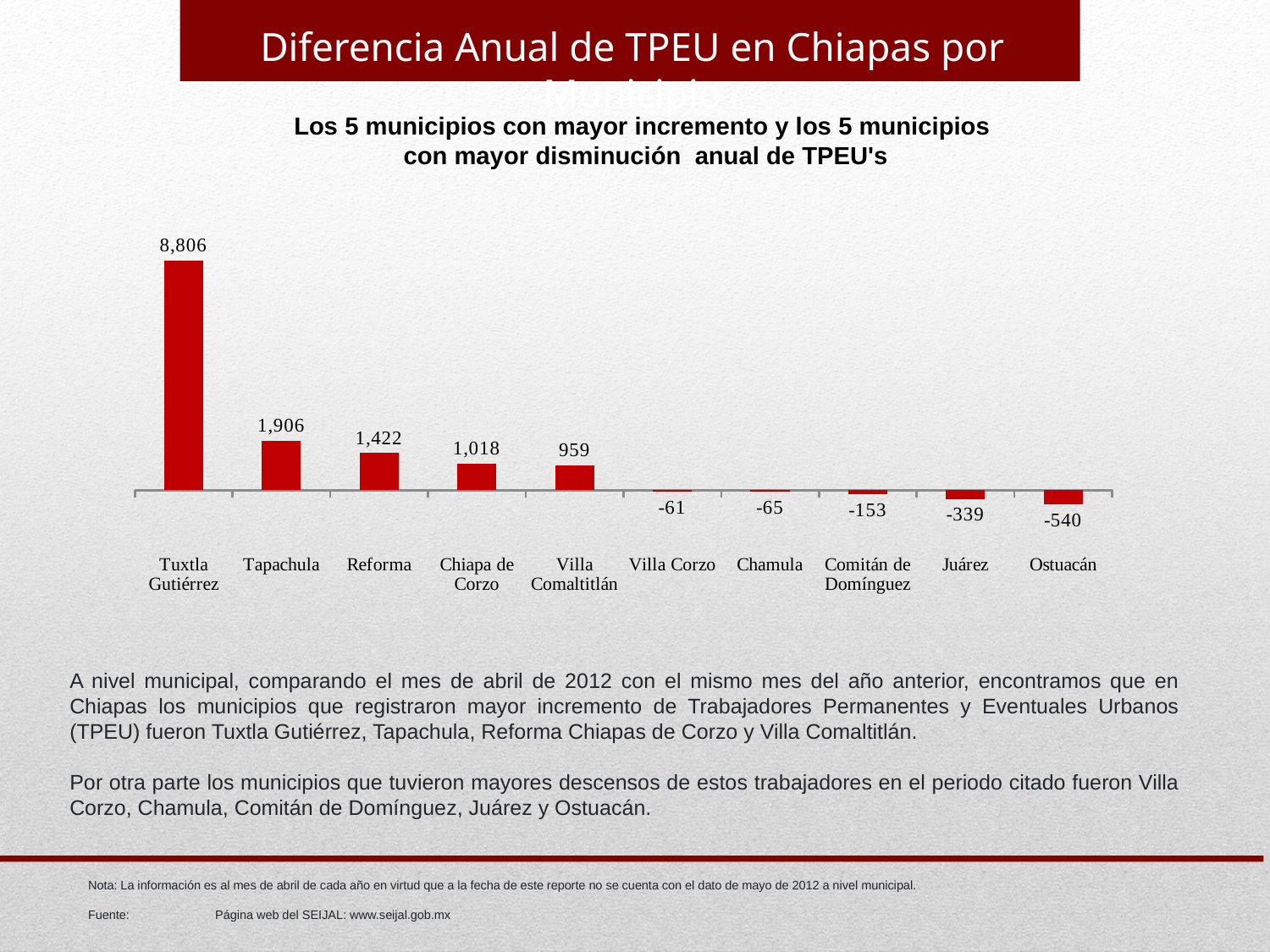
What is the difference between the values for Reforma and Chiapa de Corzo? 404 What is the value for Tuxtla Gutiérrez? 8,806 How many municipalities are shown in the chart? 10 Which is larger, the value for Juárez or the value for Chamula? Chamula What kind of chart is shown on the slide? Bar chart What is the value for Tapachula? 1,906 Which municipality has the lowest value? Ostuacán What is the value for Comitán de Domínguez? -153 What is the value for Villa Comaltitlán? 959 What is the value for Ostuacán? -540 Which municipality has the highest value? Tuxtla Gutiérrez What is the difference between the values for Tuxtla Gutiérrez and Tapachula? 6,900